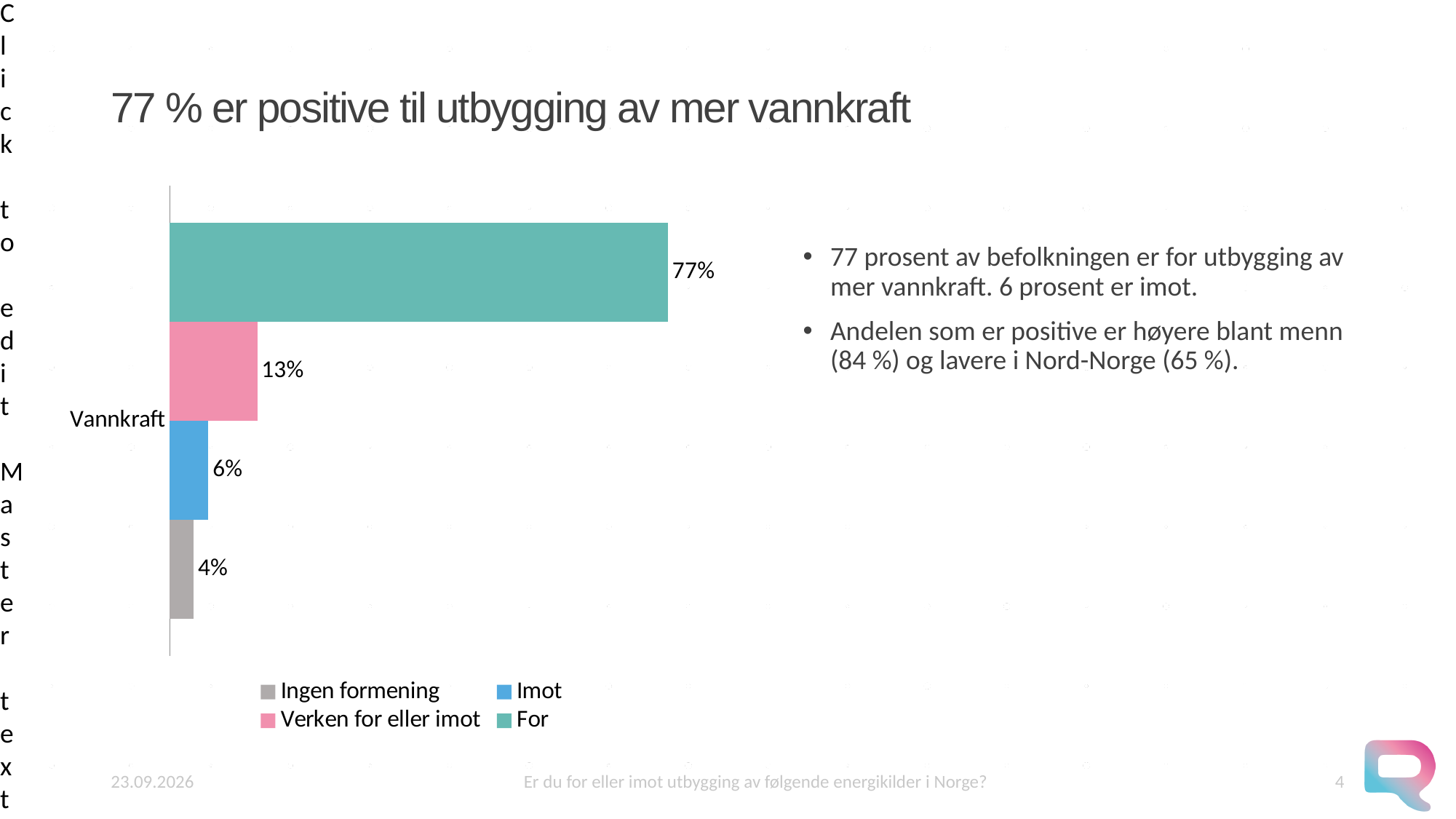
What is the value for the 'For' series for Vannkraft? 77% What colour is the bar for the 'For' series? Teal Which is larger for Vannkraft: 'Verken for eller imot' or 'Imot'? Verken for eller imot What kind of chart is shown on the slide? Bar chart What is the value for 'Ingen formening' for Vannkraft? 4% Which series has the lowest value for Vannkraft? Ingen formening What is the value for 'Imot' for Vannkraft? 6% How many categories are shown on the chart's category axis? 1 How many series does the legend list? 4 What is the difference between the 'For' and 'Imot' values for Vannkraft? 71% What is the value for 'Verken for eller imot' for Vannkraft? 13% Which series has the highest value for Vannkraft? For